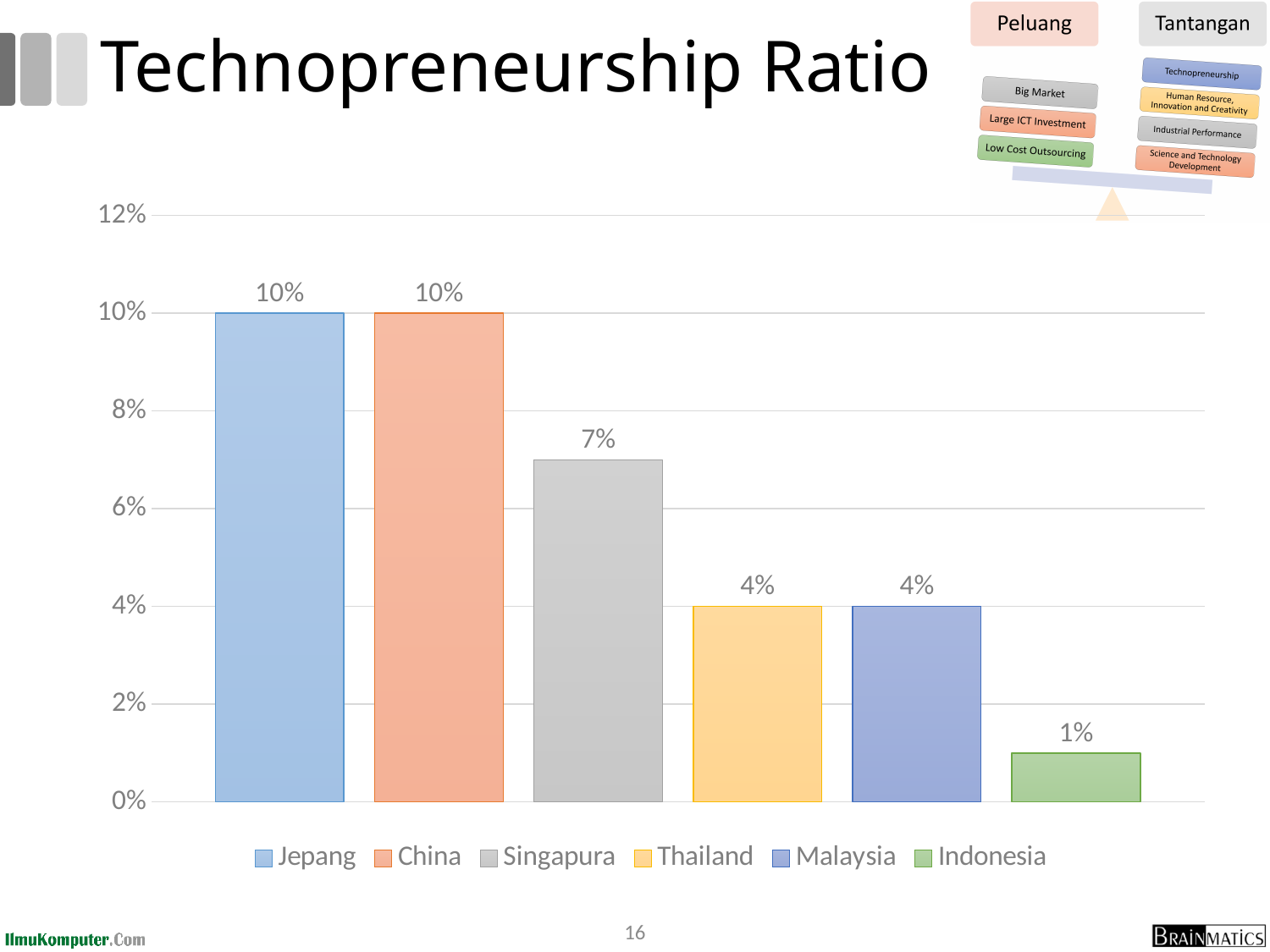
How many entries does the legend list? 6 What is the difference between the technopreneurship ratio of Singapura and Malaysia? 3% What is the technopreneurship ratio for Indonesia? 1% What is the difference between the technopreneurship ratio of Jepang and Indonesia? 9% What is the technopreneurship ratio for Thailand? 4% Which has a higher technopreneurship ratio, Singapura or Thailand? Singapura Do the values rise or fall from left to right across the chart? Fall Which has a higher technopreneurship ratio, Malaysia or Indonesia? Malaysia Which country has the lowest technopreneurship ratio? Indonesia What kind of chart is shown on the slide? Bar chart What is the technopreneurship ratio for Singapura? 7% How many countries are shown in the chart? 6